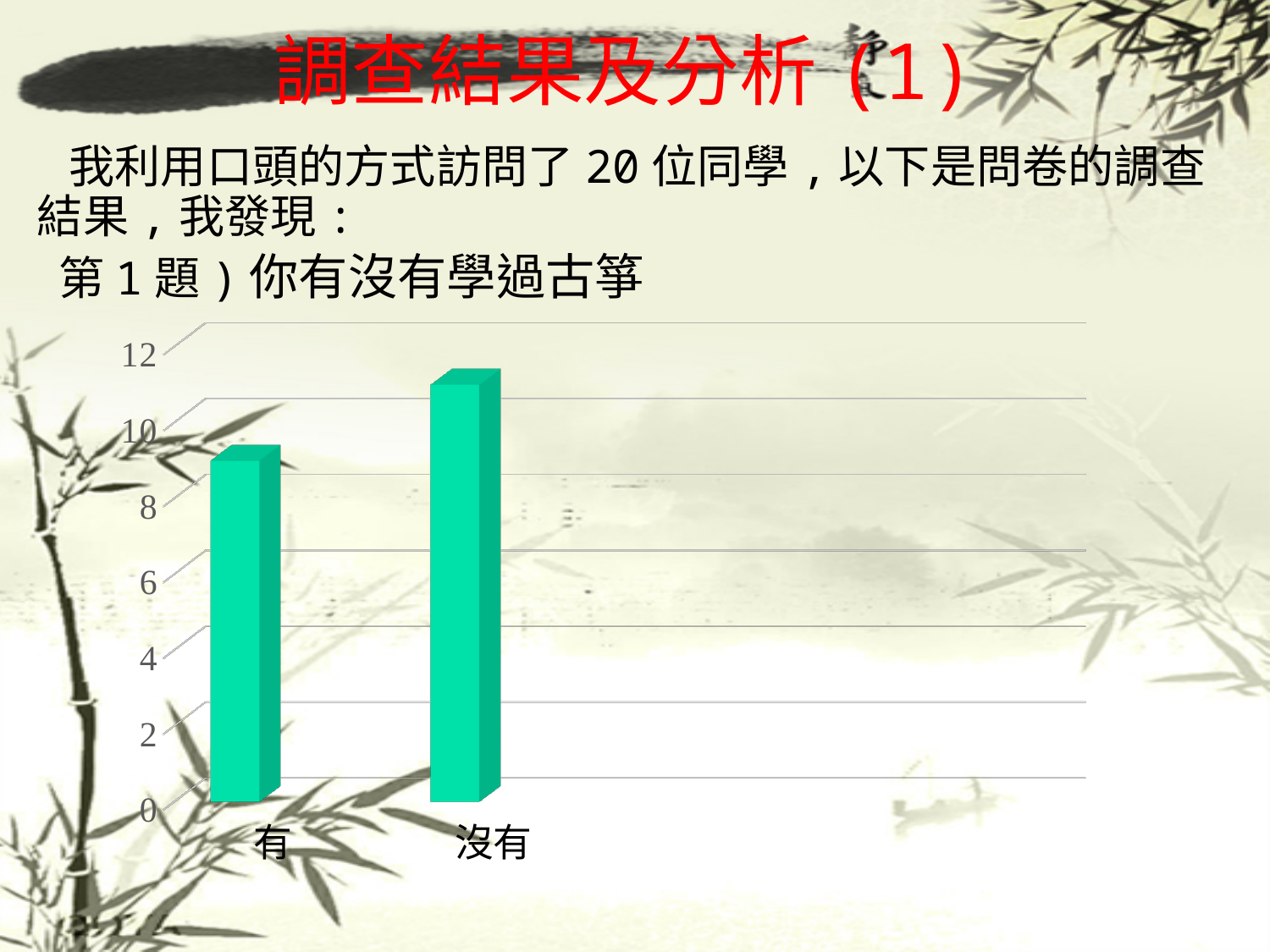
How many categories are shown on the x axis of the chart? 2 Is the value for 沒有 greater or less than 10? greater What is the highest tick value shown on the vertical axis of the chart? 12 Is the value for 沒有 greater or less than 12? less Is the value for 有 greater or less than 10? less Which category has the lowest bar in the chart? 有 What are the two category labels on the x axis of the chart? 有, 沒有 Which category has the highest bar in the chart? 沒有 What kind of chart is shown on the slide? bar chart Which is larger, the value for 有 or the value for 沒有? 沒有